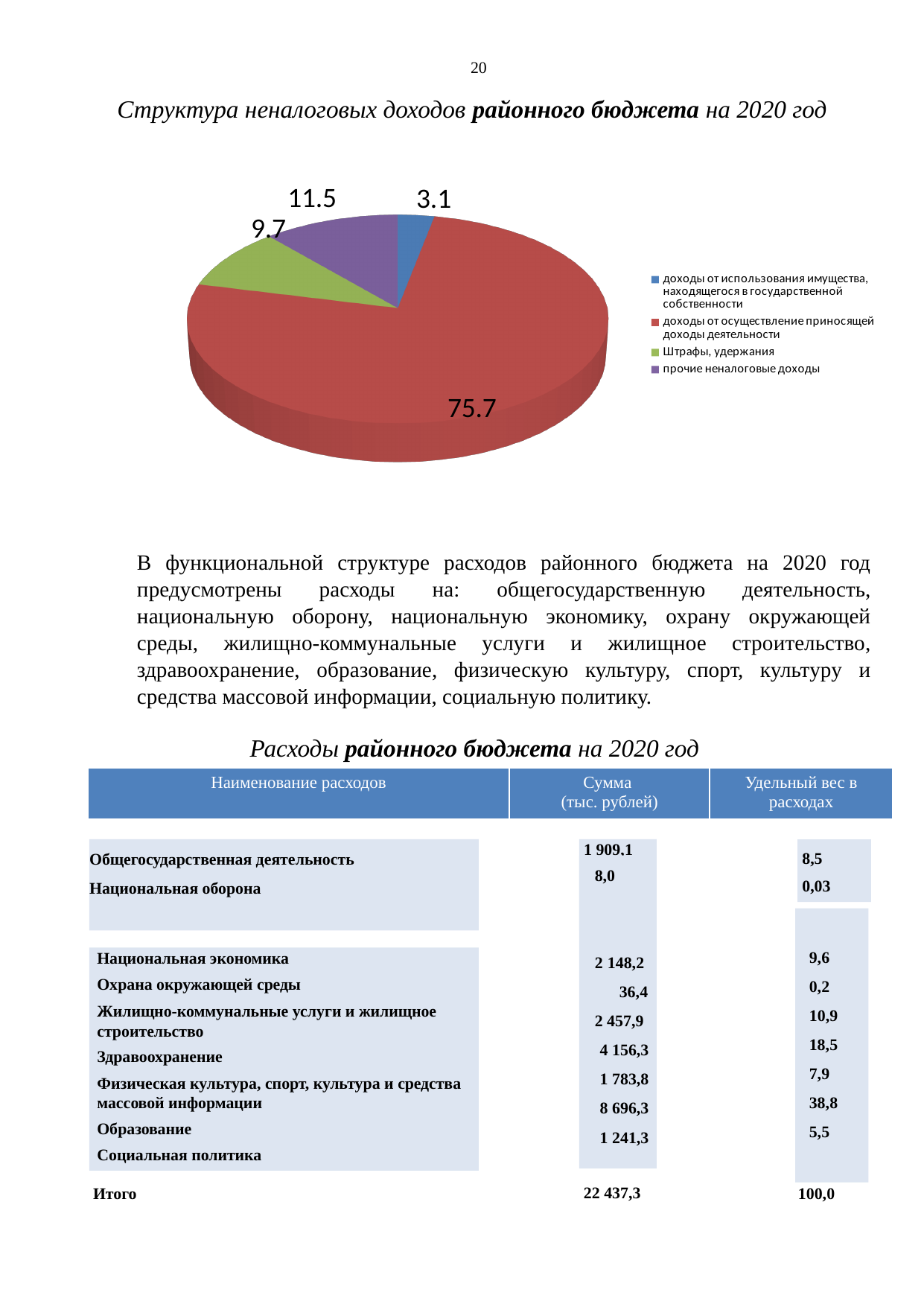
What is the value shown for the slice "Штрафы, удержания"? 9.7 Which category has the smallest slice of the pie? доходы от использования имущества, находящегося в государственной собственности What is the title of the pie chart? Структура неналоговых доходов районного бюджета на 2020 год How many slices does the pie chart have? 4 What is the value shown for the slice "доходы от осуществление приносящей доходы деятельности"? 75.7 How many entries does the legend of the pie chart list? 4 What type of chart is shown on the slide? Pie chart Which category has the largest slice of the pie? доходы от осуществление приносящей доходы деятельности Which is larger: the slice for "Штрафы, удержания" or the slice for "прочие неналоговые доходы"? прочие неналоговые доходы What is the value shown for the slice "доходы от использования имущества, находящегося в государственной собственности"? 3.1 What is the difference between the values for "прочие неналоговые доходы" and "Штрафы, удержания"? 1.8 What is the value shown for the slice "прочие неналоговые доходы"? 11.5